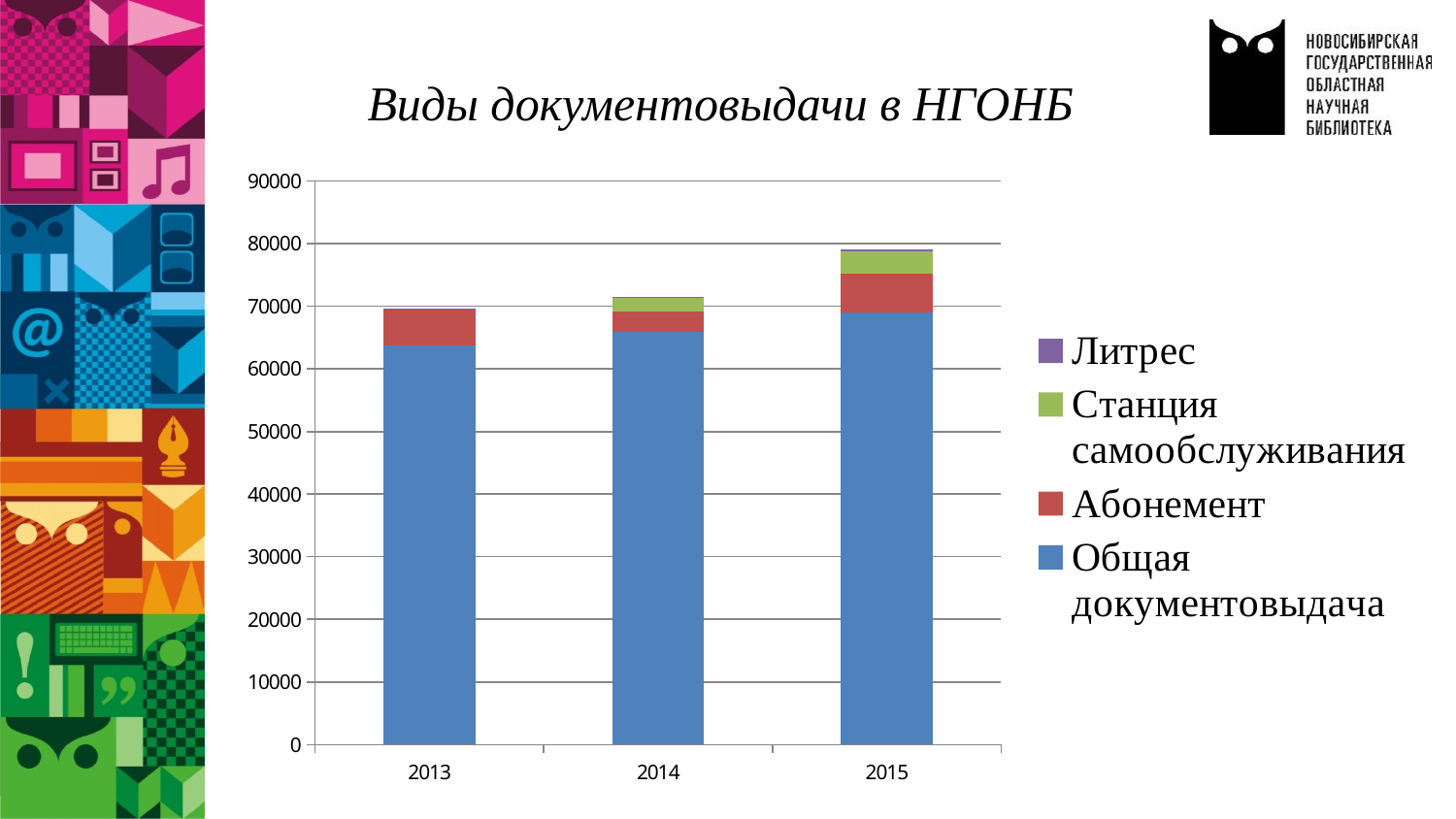
Is the value of Общая документовыдача for 2013 greater or less than 60000? greater What is the title of the chart? Виды документовыдачи в НГОНБ Which legend entry is shown in blue? Общая документовыдача What kind of chart is shown on the slide? stacked bar chart Is the total stacked bar for 2015 greater or less than 80000? less Which is larger, the total stacked bar for 2013 or for 2015? 2015 Do the total bar heights rise or fall from 2013 to 2015? rise Is the value of Общая документовыдача for 2015 greater or less than 70000? less Which year has the tallest stacked bar? 2015 How many years are shown on the x axis of the chart? 3 Which year has the shortest stacked bar? 2013 How many series does the chart legend list? 4